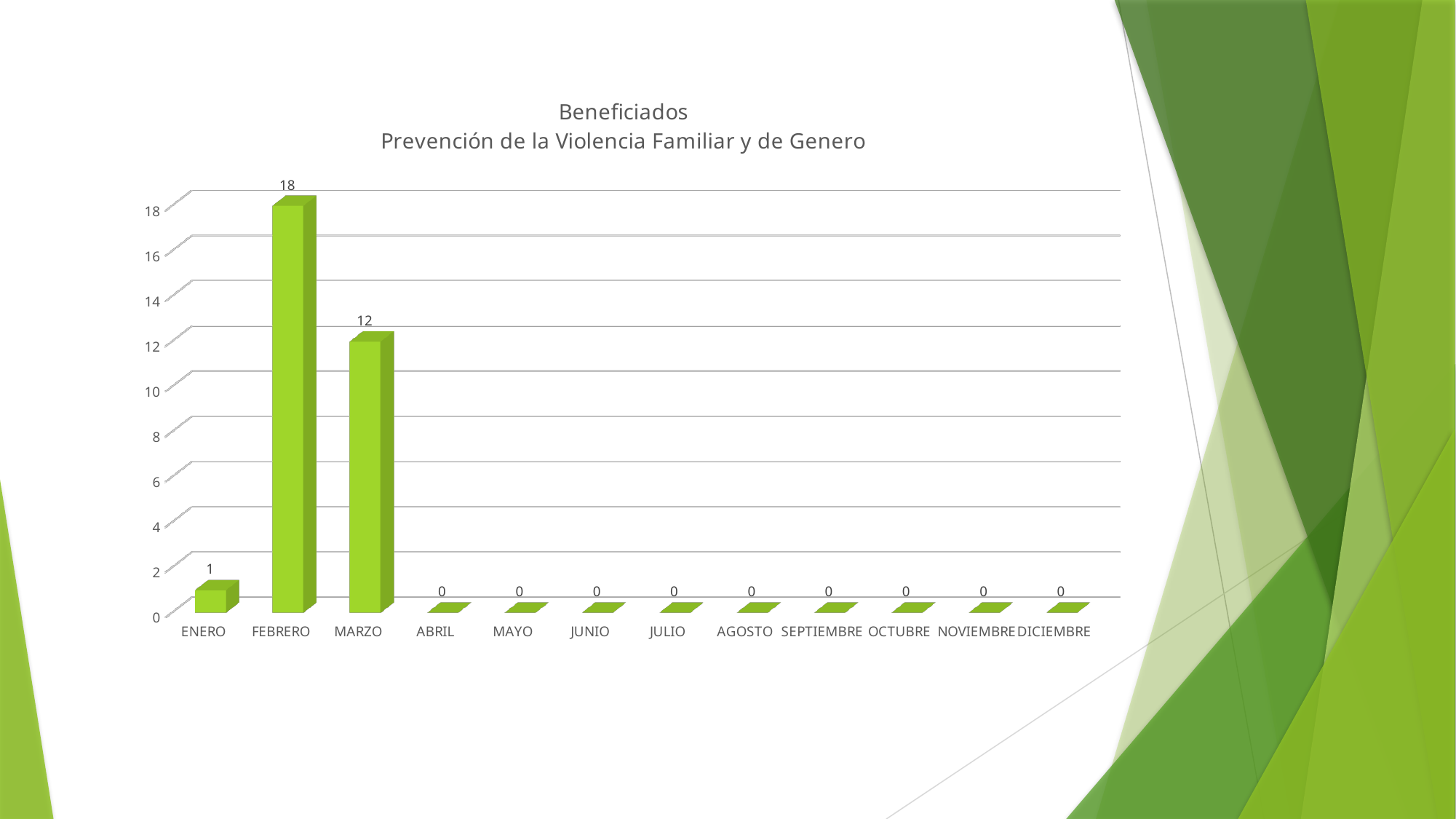
What is the value for FEBRERO? 18 Which month has the highest value? FEBRERO Which is larger, the value for FEBRERO or the value for MARZO? FEBRERO What kind of chart is shown on the slide? bar chart What is the value for ENERO? 1 How many months are shown on the x axis? 12 What is the value for ABRIL? 0 What is the difference between the values for MARZO and ENERO? 11 What is the value for MARZO? 12 What is the title of the chart? Beneficiados Prevención de la Violencia Familiar y de Genero Is the value for FEBRERO greater or less than 10? greater What is the difference between the values for FEBRERO and MARZO? 6